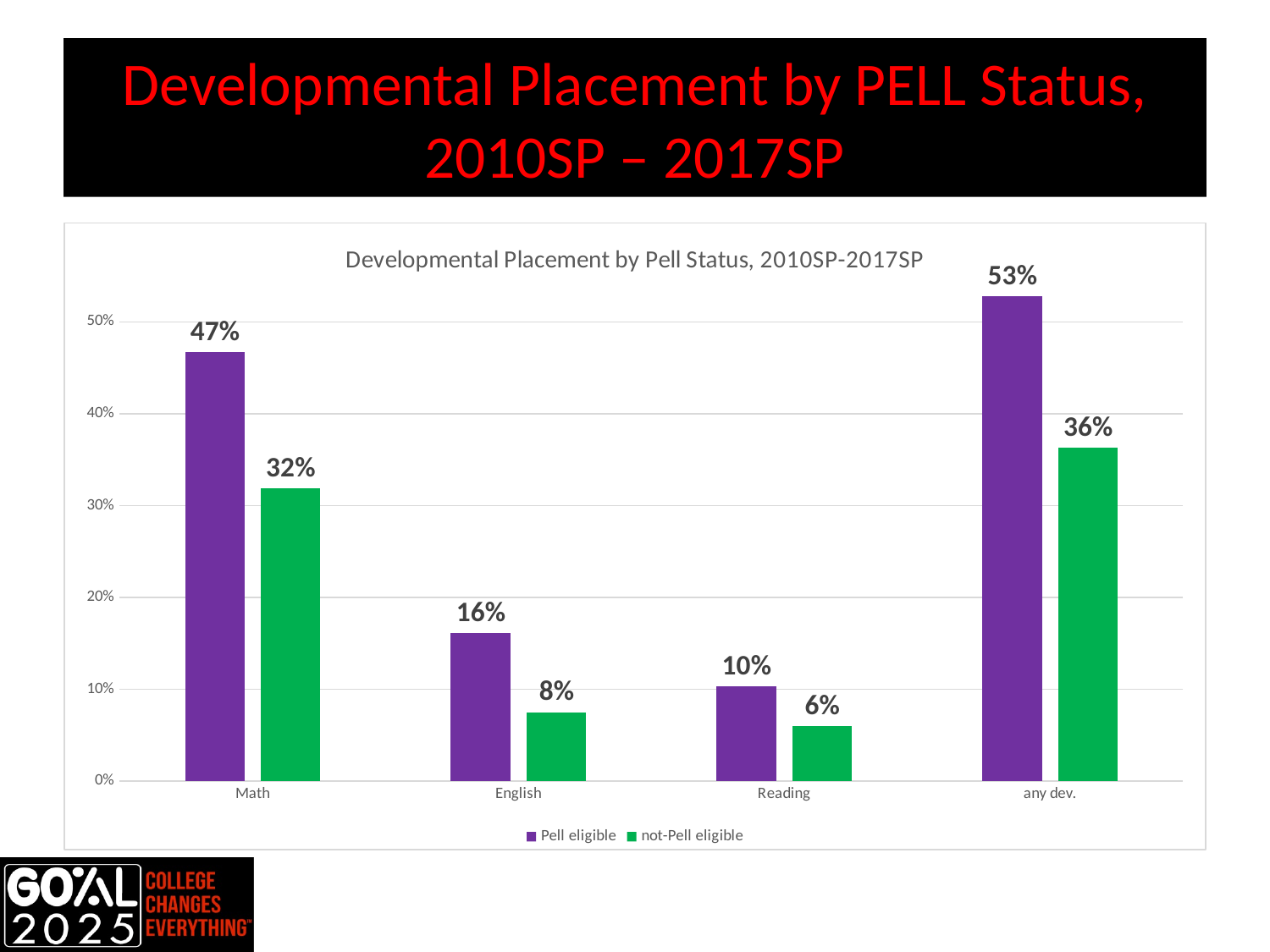
What kind of chart is shown on the slide? bar chart What is the Pell eligible value for Math? 47% Which is larger for Reading: the Pell eligible value or the not-Pell eligible value? Pell eligible Which category has the lowest not-Pell eligible value? Reading Is the not-Pell eligible value for Math greater or less than 30%? greater How many series does the legend list? 2 Which category has the highest Pell eligible value? any dev. What is the difference between the Pell eligible and not-Pell eligible values for English? 8% How many categories are shown on the x axis? 4 What is the difference between the Pell eligible and not-Pell eligible values for Math? 15% What is the not-Pell eligible value for any dev.? 36% What is the not-Pell eligible value for Reading? 6%